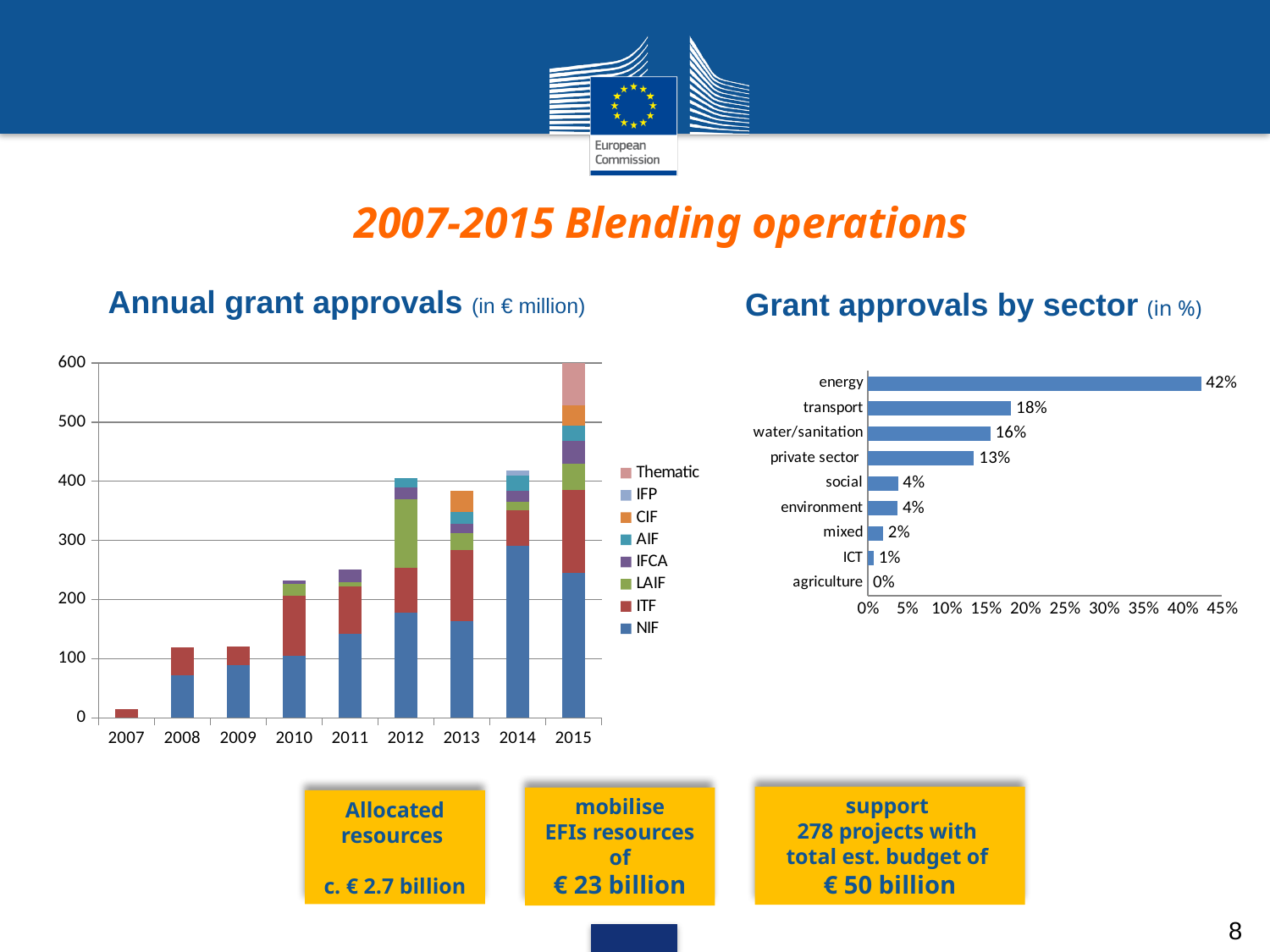
What kind of chart is the 'Annual grant approvals' chart? stacked bar chart In the 'Grant approvals by sector' chart, which is larger, the value for transport or the value for private sector? transport In the 'Grant approvals by sector' chart, what is the value for energy? 42% In the 'Grant approvals by sector' chart, what is the value for water/sanitation? 16% In the 'Grant approvals by sector' chart, what is the value for private sector? 13% How many sectors are shown in the 'Grant approvals by sector' chart? 9 In the 'Grant approvals by sector' chart, what is the difference between the values for energy and transport? 24% In the 'Grant approvals by sector' chart, which sector has the lowest share? agriculture In the 'Grant approvals by sector' chart, which sector has the highest share? energy How many series does the legend of the 'Annual grant approvals' chart list? 8 In the 'Annual grant approvals' chart, which year has the highest total grant approvals? 2015 In the 'Annual grant approvals' chart, is the total for 2015 greater or less than 500? greater